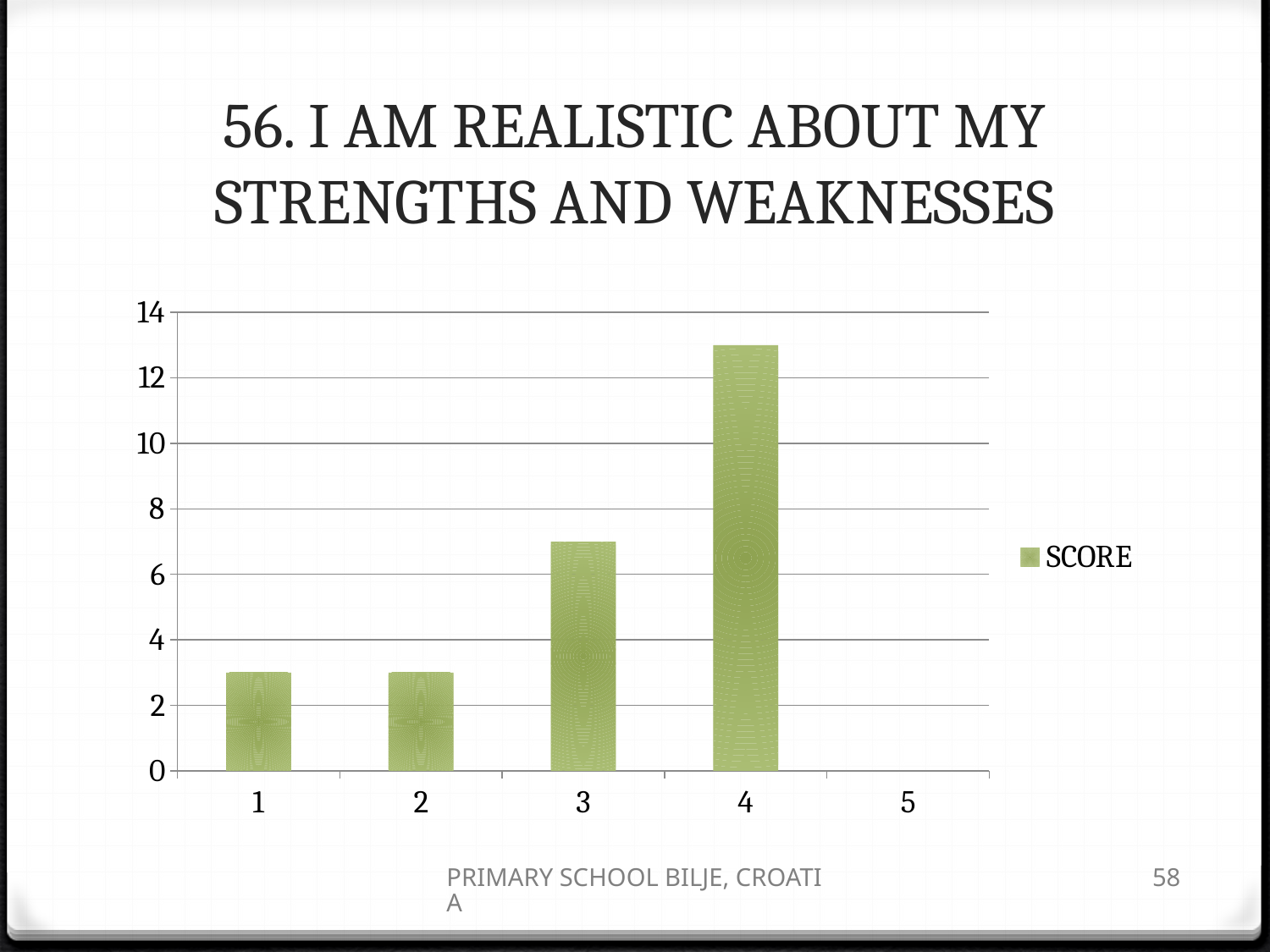
Which has a larger SCORE, category 3 or category 4? 4 Is the SCORE for category 3 greater or less than 8? less Is the SCORE for category 3 greater or less than 6? greater What kind of chart is shown on the slide? bar chart Which category has the lowest SCORE? 5 Which has a larger SCORE, category 2 or category 3? 3 What is the name of the series shown in the legend? SCORE Is the SCORE for category 1 greater or less than 4? less Which category has the highest SCORE? 4 How many series does the legend list? 1 How many categories are shown on the x axis? 5